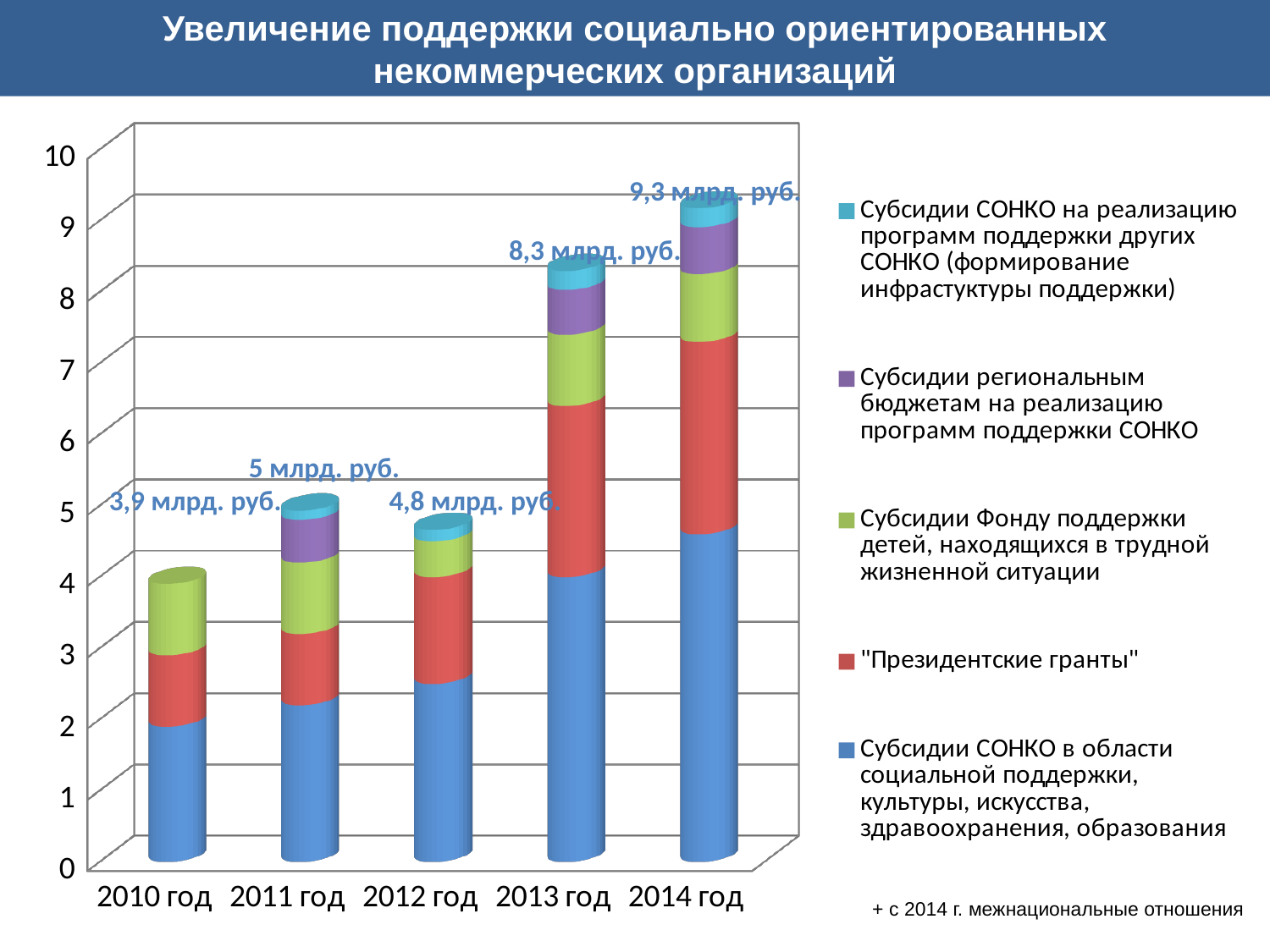
Which year has the highest total support? 2014 год How many years are shown on the x axis? 5 What is the total support shown for 2012 год? 4,8 млрд. руб. What kind of chart is shown on the slide? Stacked bar chart What is the total support shown for 2014 год? 9,3 млрд. руб. By how much did the total support increase from 2013 год to 2014 год? 1 млрд. руб. What is the difference between the totals for 2013 год and 2012 год? 3,5 млрд. руб. What is the total support shown for 2010 год? 3,9 млрд. руб. Is the value of the blue segment (Субсидии СОНКО в области социальной поддержки, культуры, искусства, здравоохранения, образования) for 2014 год greater or less than 4? greater How many series does the legend list? 5 Which year has a larger total: 2011 год or 2012 год? 2011 год Which year has the lowest total support? 2010 год